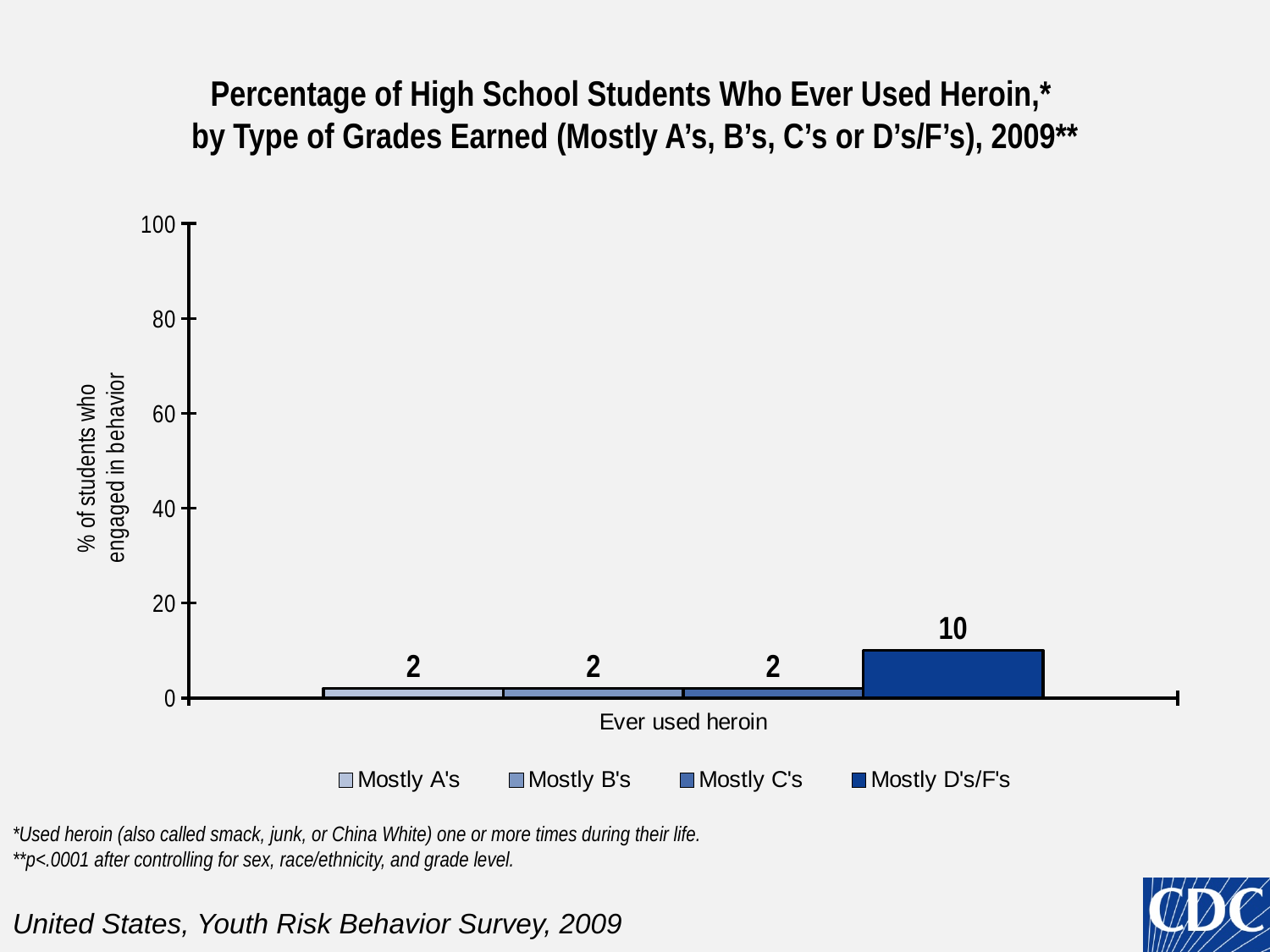
What kind of chart is shown on the slide? bar chart What is the difference between the values for Mostly D's/F's and Mostly B's? 8 How many bars are plotted in the chart? 4 Which grade group has the highest percentage of students who ever used heroin? Mostly D's/F's What is the value for Mostly A's students who ever used heroin? 2 What is the maximum value shown on the y axis? 100 What is the value for Mostly D's/F's students who ever used heroin? 10 Is the value for Mostly D's/F's greater or less than 20? less Which is larger, the value for Mostly D's/F's or the value for Mostly A's? Mostly D's/F's What is the label on the x axis category? Ever used heroin What is the value for Mostly C's students who ever used heroin? 2 How many series does the legend list? 4